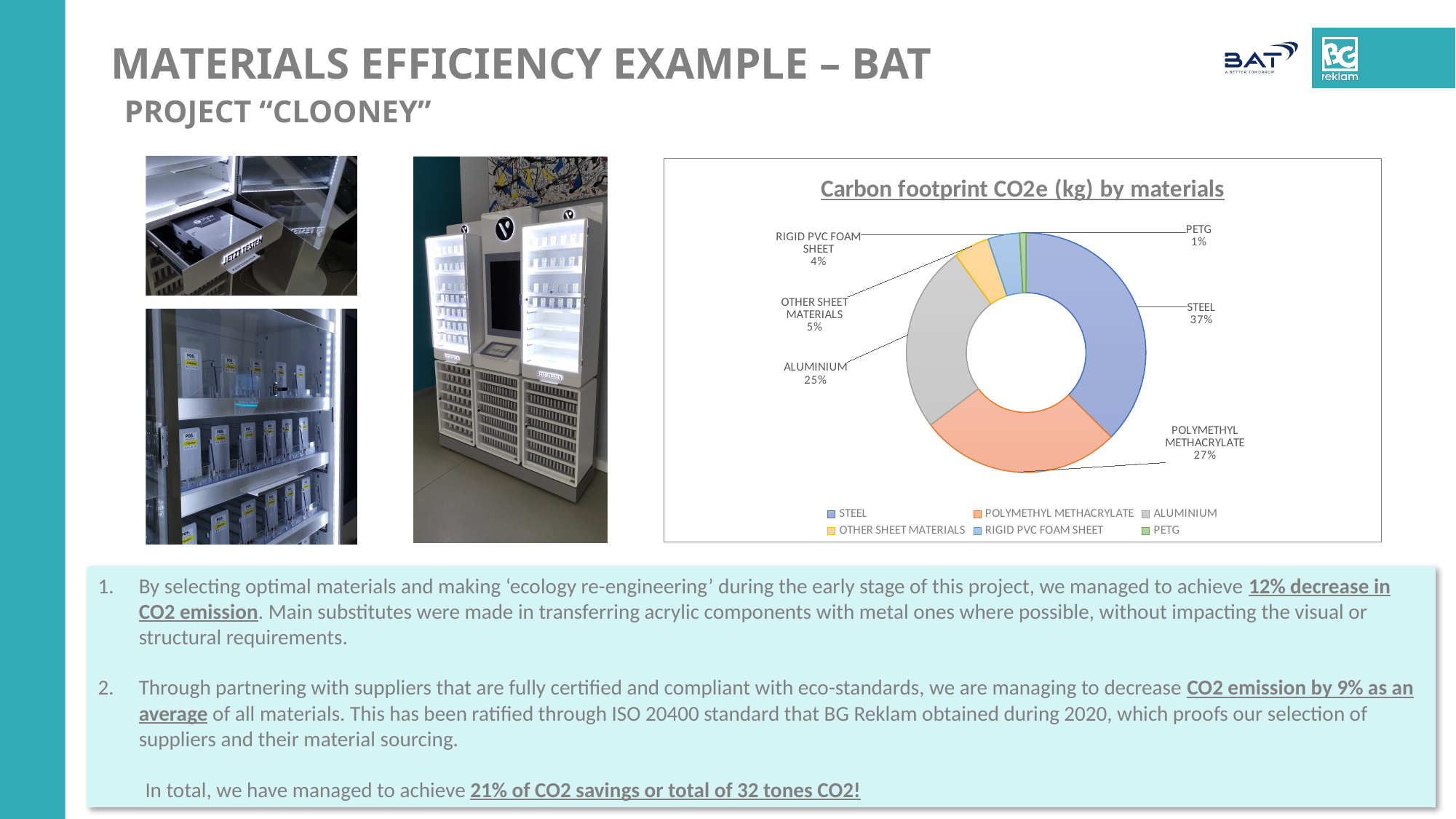
Which material has the smallest share of the carbon footprint? PETG Which has a larger share, POLYMETHYL METHACRYLATE or OTHER SHEET MATERIALS? POLYMETHYL METHACRYLATE What kind of chart is shown on the slide? Doughnut (pie) chart What share of the carbon footprint does STEEL account for? 37% What share of the carbon footprint does POLYMETHYL METHACRYLATE account for? 27% What is the title of the chart? Carbon footprint CO2e (kg) by materials What share of the carbon footprint does PETG account for? 1% Which material has the largest share of the carbon footprint? STEEL What is the difference in percentage points between the STEEL share and the ALUMINIUM share? 12 percentage points How many materials are shown in the chart? 6